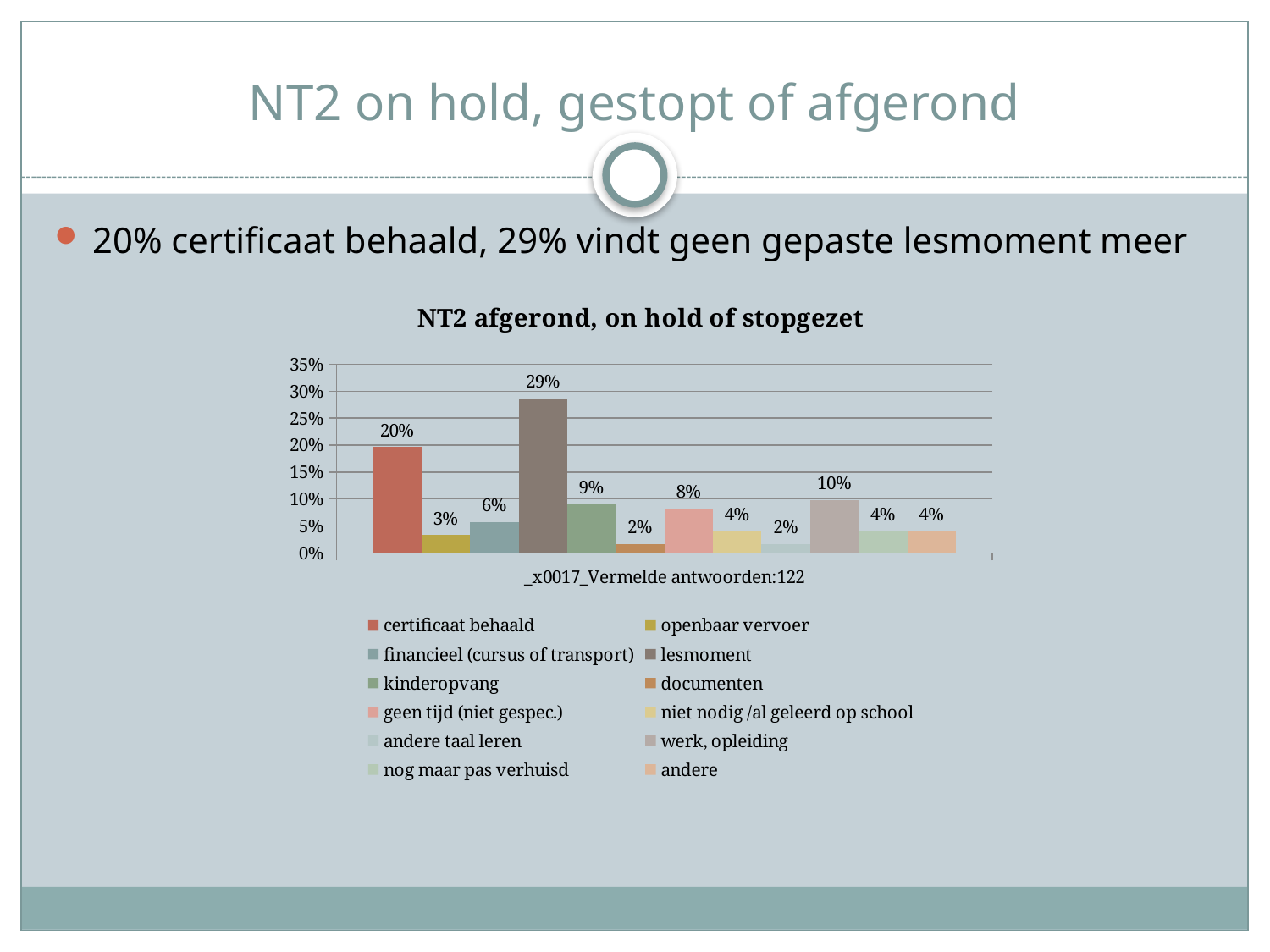
What is the value for werk, opleiding? 10% What is the difference between the values for lesmoment and certificaat behaald? 9% Which is larger, the value for geen tijd (niet gespec.) or the value for financieel (cursus of transport)? geen tijd (niet gespec.) What is the value for kinderopvang? 9% Which series has the highest value? lesmoment What is the value for certificaat behaald? 20% What is the difference between the values for werk, opleiding and documenten? 8% What is the title of the chart? NT2 afgerond, on hold of stopgezet What kind of chart is shown on the slide? bar chart Is the value for lesmoment greater or less than 25%? greater How many series does the legend list? 12 What is the value for lesmoment? 29%